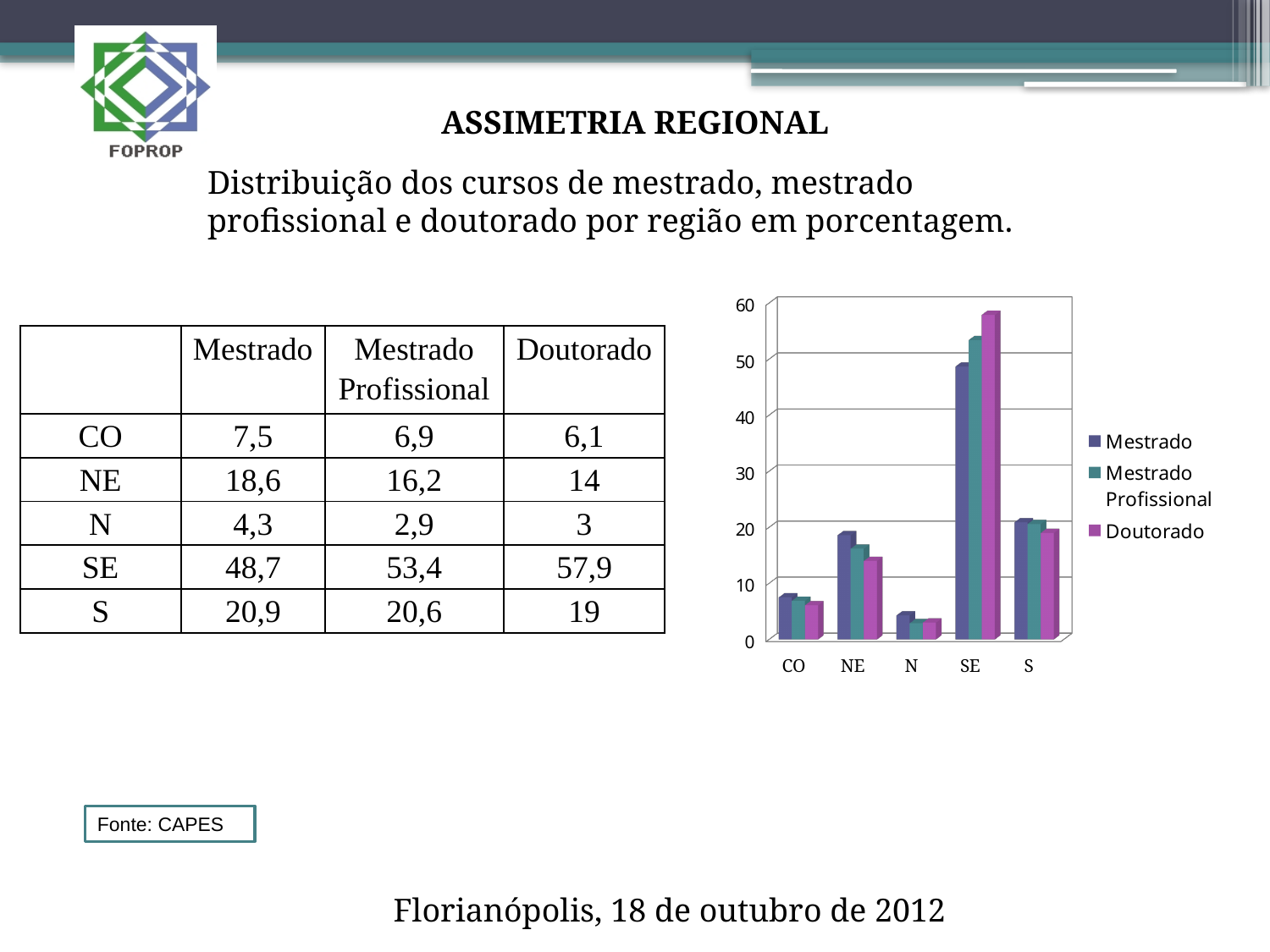
What is the Doutorado value for NE? 14 Which is larger for CO: the Mestrado value or the Doutorado value? Mestrado How many regions (categories) are shown on the x axis of the chart? 5 Which region has the lowest Mestrado value in the chart? N What is the difference between the Doutorado and Mestrado values for SE? 9,2 Which series is shown in purple in the chart's legend? Doutorado What kind of chart is shown on the slide? bar chart Which region has the highest Doutorado value in the chart? SE How many series does the chart's legend list? 3 What is the Mestrado value for SE? 48,7 What is the Mestrado Profissional value for S? 20,6 Is the Mestrado value for NE greater or less than 10? greater